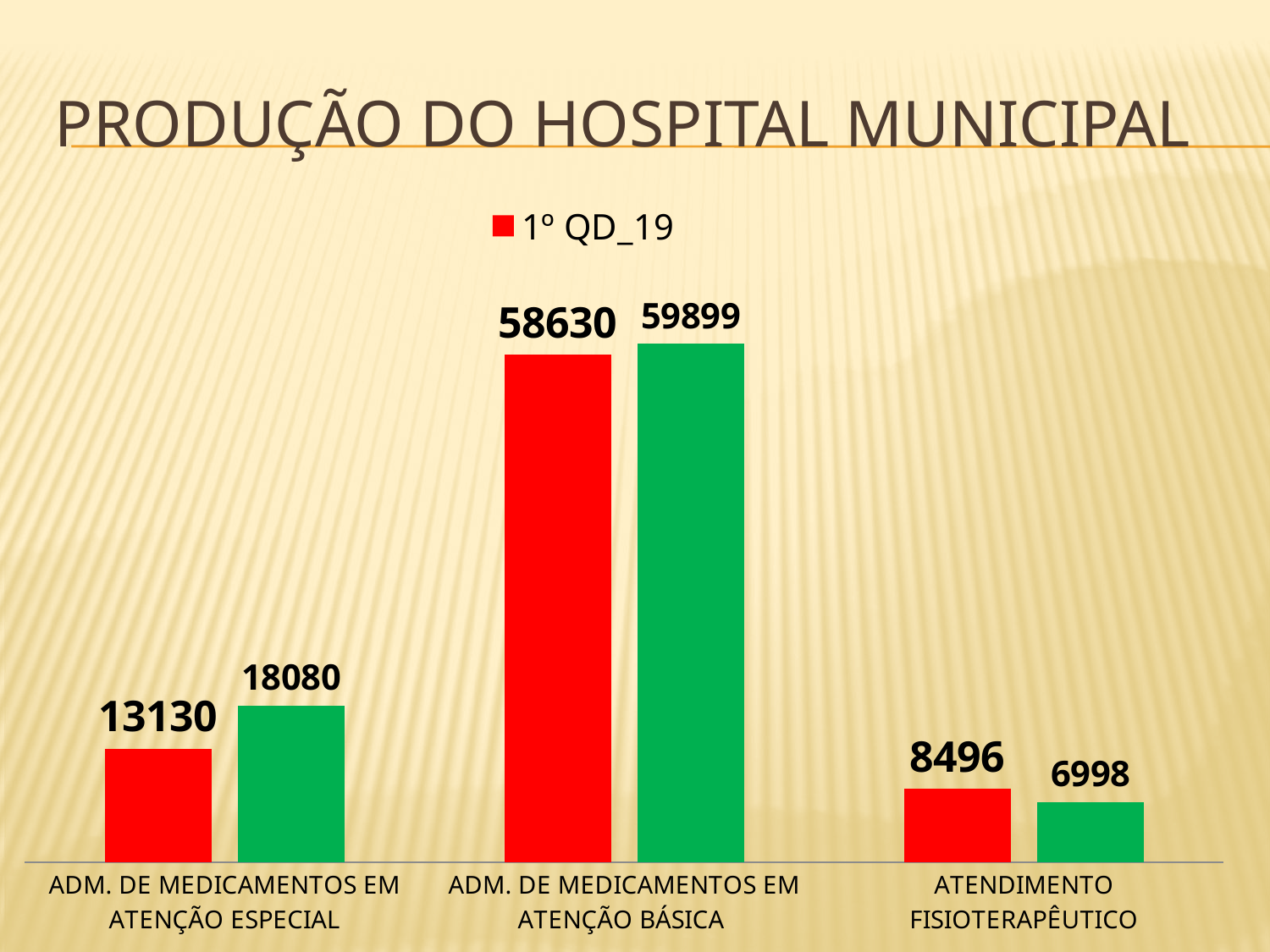
What is the difference between the 1º QD_19 values for ADM. DE MEDICAMENTOS EM ATENÇÃO BÁSICA and ADM. DE MEDICAMENTOS EM ATENÇÃO ESPECIAL? 45500 How many series does the legend list? 1 Which category has the lowest 1º QD_19 value? ATENDIMENTO FISIOTERAPÊUTICO What type of chart is shown on the slide? bar chart What is the value of the red 1º QD_19 bar for ATENDIMENTO FISIOTERAPÊUTICO? 8496 For ADM. DE MEDICAMENTOS EM ATENÇÃO ESPECIAL, how much larger is the green bar than the red 1º QD_19 bar? 4950 How many categories are shown on the x axis of the chart? 3 What value is shown on the green bar for ATENDIMENTO FISIOTERAPÊUTICO? 6998 What is the value of 1º QD_19 for ADM. DE MEDICAMENTOS EM ATENÇÃO ESPECIAL? 13130 What value is shown on the green bar for ADM. DE MEDICAMENTOS EM ATENÇÃO BÁSICA? 59899 For ATENDIMENTO FISIOTERAPÊUTICO, which bar is larger, the red one or the green one? the red one Which category has the highest 1º QD_19 value? ADM. DE MEDICAMENTOS EM ATENÇÃO BÁSICA